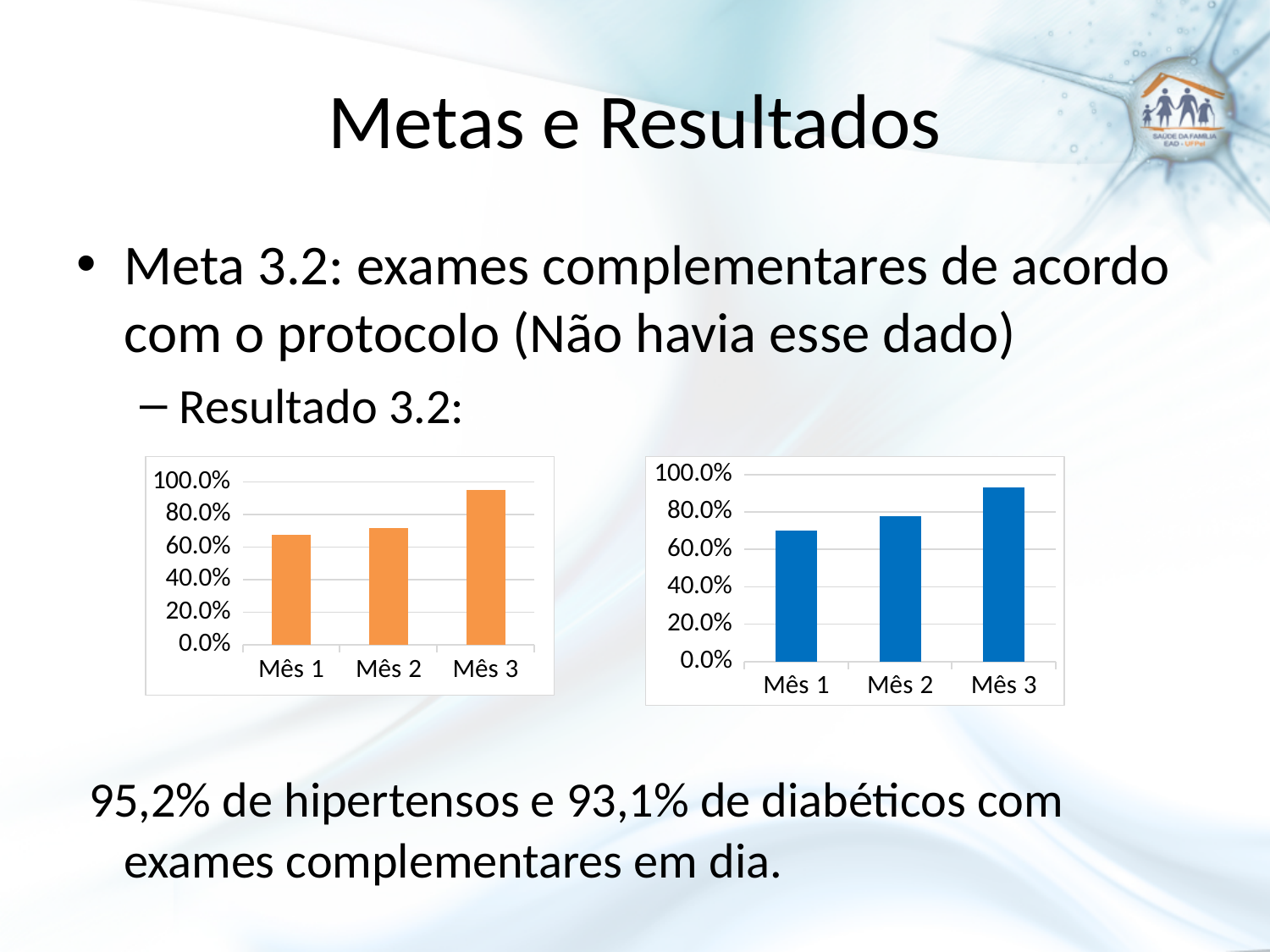
In the chart on the right of the slide, which month has the highest value? Mês 3 In the chart on the left of the slide, which month has the highest value? Mês 3 In the chart on the right of the slide, which is larger, the value for Mês 2 or the value for Mês 3? Mês 3 What kind of chart is the chart on the left of the slide? bar chart In the chart on the right of the slide, which month has the lowest value? Mês 1 In the chart on the left of the slide, is the value for Mês 1 greater or less than 60.0%? greater How many categories does the chart on the right of the slide show? 3 In the chart on the right of the slide, is the value for Mês 1 greater or less than 60.0%? greater In the chart on the left of the slide, is the value for Mês 2 greater or less than 80.0%? less In the chart on the right of the slide, do the values rise or fall from Mês 1 to Mês 3? rise